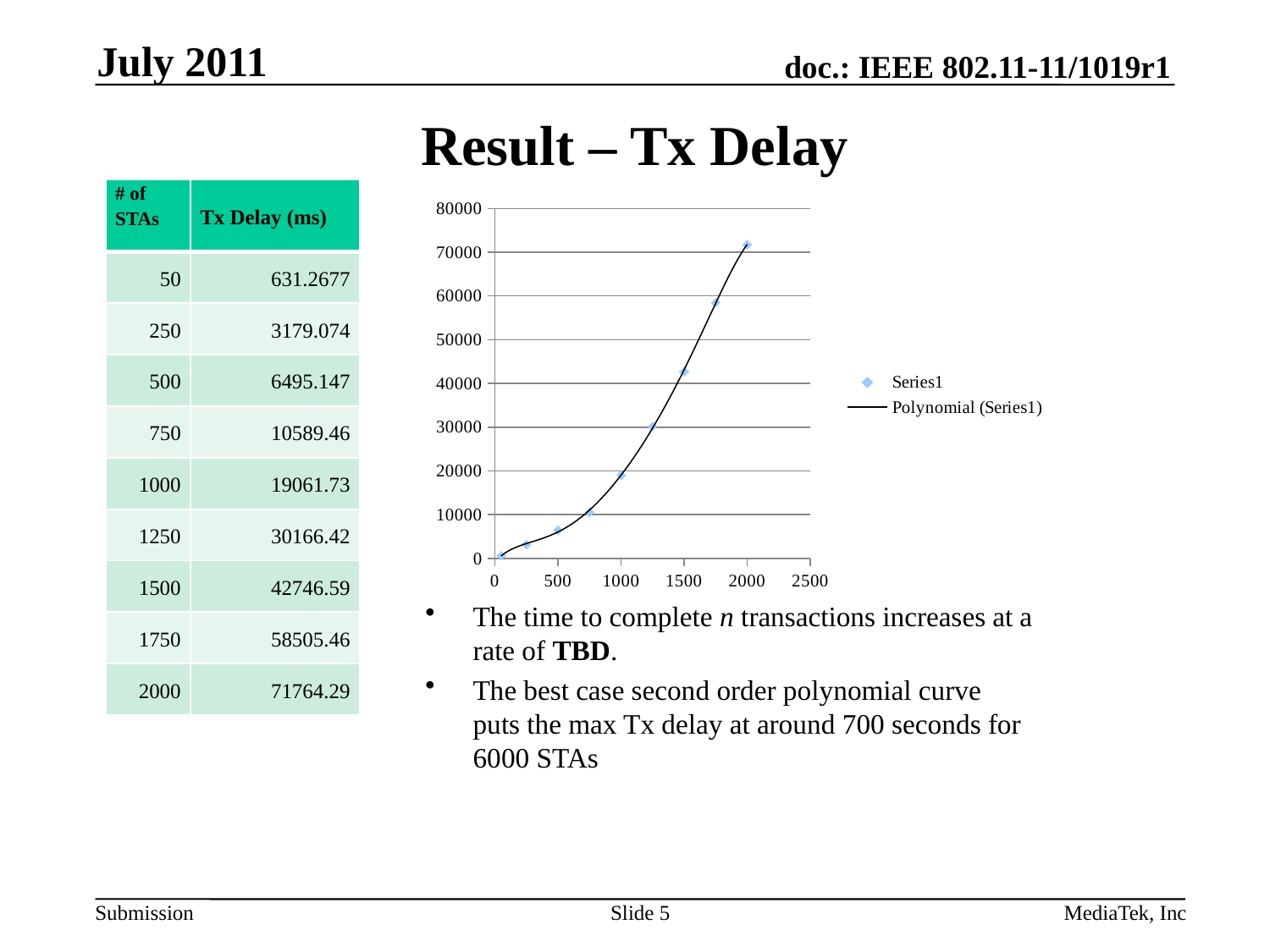
What is the Tx delay (ms) for 1000 STAs? 19061.73 At which number of STAs is the Tx delay highest? 2000 Do the plotted values rise or fall as the number of STAs increases along the x axis? rise What are the two entries in the chart legend? Series1 and Polynomial (Series1) How many data points are plotted in the chart? 9 At which number of STAs is the Tx delay lowest? 50 Which has the larger Tx delay, 1250 STAs or 750 STAs? 1250 STAs Is the plotted value at 1500 STAs greater or less than 40000? greater How many entries does the chart legend list? 2 Is the plotted value at 500 STAs greater or less than 10000? less What kind of chart is shown on the slide? scatter chart What is the Tx delay (ms) for 2000 STAs? 71764.29